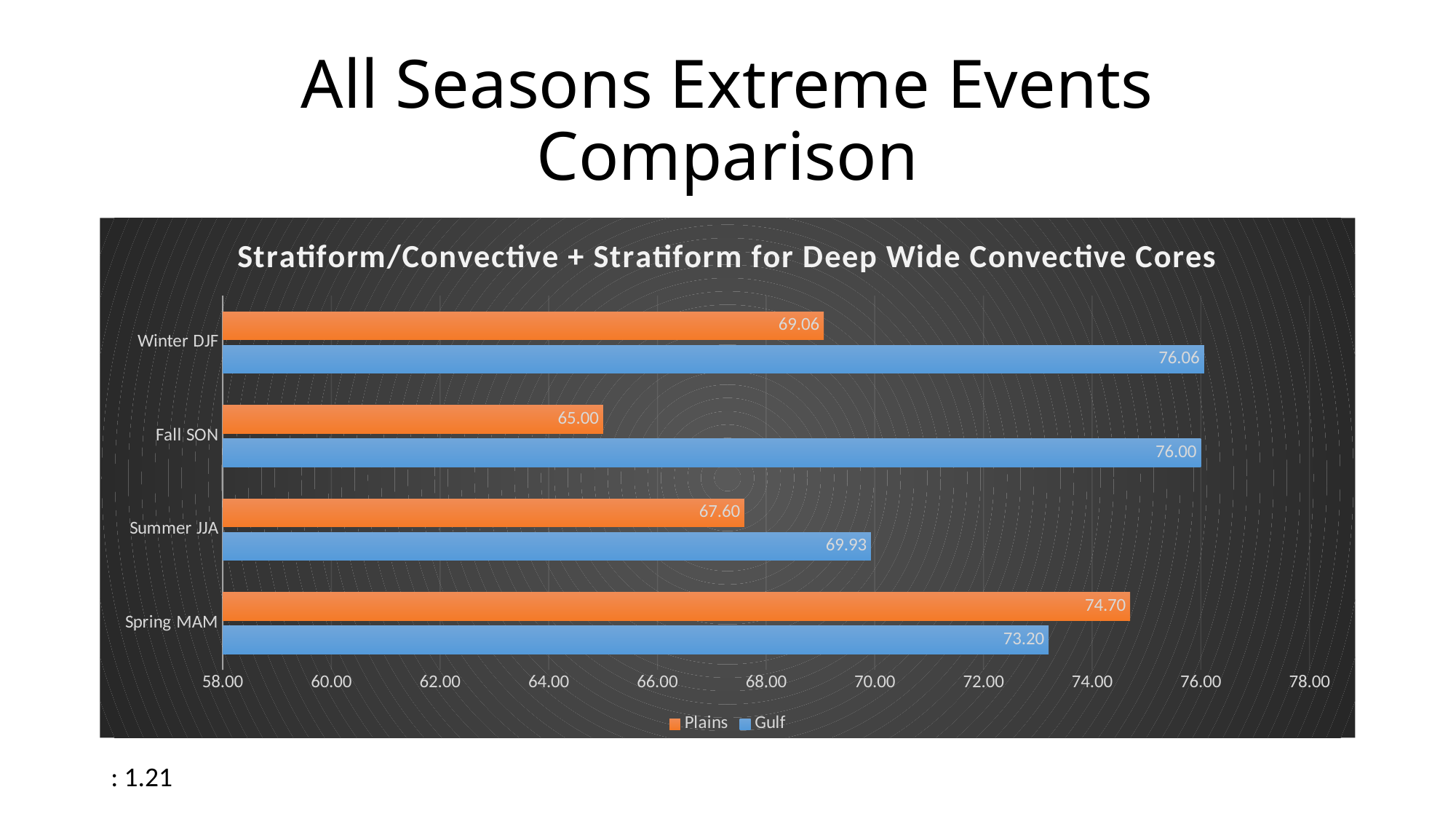
What is the Gulf value for Summer JJA? 69.93 What kind of chart is shown on the slide? Bar chart For Spring MAM, which series has the larger value, Plains or Gulf? Plains How many seasons are shown on the chart? 4 How many series does the legend list? 2 Which season has the lowest Plains value? Fall SON What is the Plains value for Winter DJF? 69.06 Which season has the highest Gulf value? Winter DJF What is the Plains value for Spring MAM? 74.70 What is the title of the chart? Stratiform/Convective + Stratiform for Deep Wide Convective Cores What is the Gulf value for Fall SON? 76.00 What is the difference between the Gulf and Plains values for Fall SON? 11.00